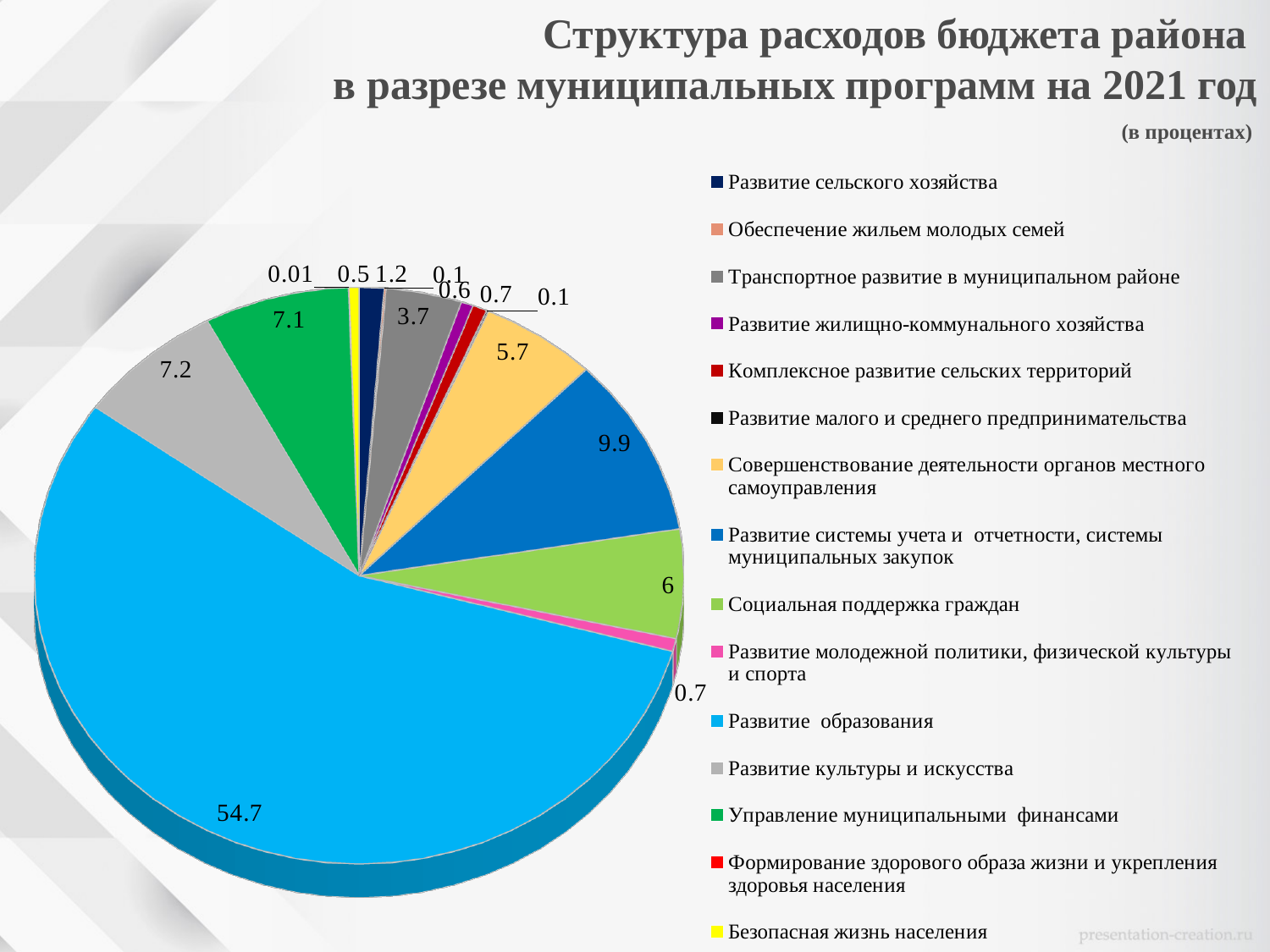
What is the value for Транспортное развитие в муниципальном районе? 3.7 What is the value for Развитие образования? 54.7 What is the value for Управление муниципальными финансами? 7.1 How many categories does the legend list? 15 What is the value for Развитие культуры и искусства? 7.2 What is the difference between the values for Развитие образования and Развитие системы учета и отчетности, системы муниципальных закупок? 44.8 What is the value for Развитие системы учета и отчетности, системы муниципальных закупок? 9.9 Which category has the largest share of the pie? Развитие образования What is the value for Социальная поддержка граждан? 6 What type of chart is shown on the slide? pie chart Which is larger: the value for Социальная поддержка граждан or the value for Совершенствование деятельности органов местного самоуправления? Социальная поддержка граждан What is the value for Совершенствование деятельности органов местного самоуправления? 5.7